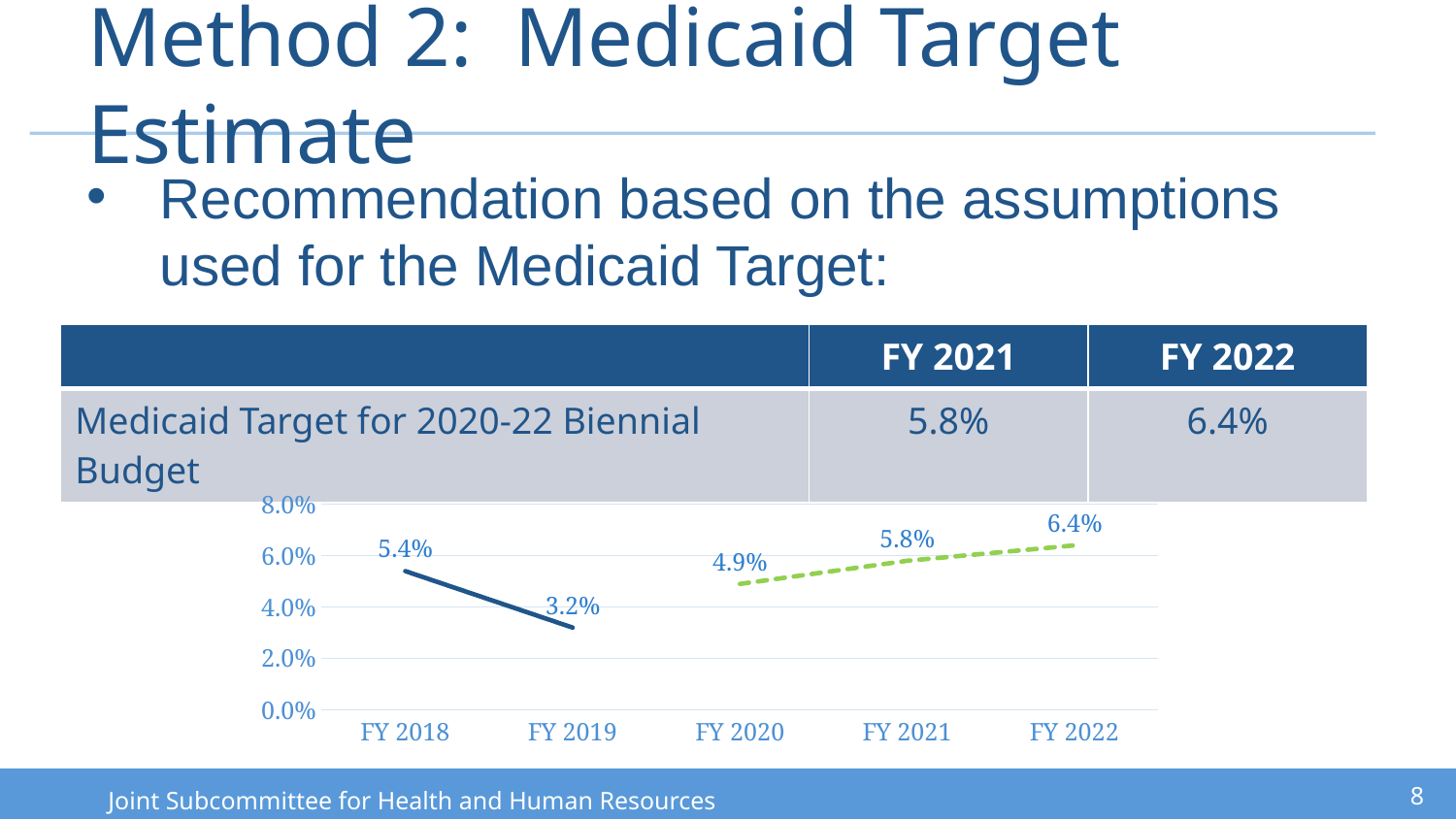
Which fiscal year has the highest value on the line chart? FY 2022 How many fiscal years are shown on the x axis of the line chart? 5 What is the value for FY 2020 on the line chart? 4.9% Which is larger on the line chart, the value for FY 2018 or the value for FY 2020? FY 2018 Do the values on the line chart rise or fall from FY 2020 to FY 2022? Rise What is the value for FY 2019 on the line chart? 3.2% What is the difference between the FY 2018 value and the FY 2019 value on the line chart? 2.2% What kind of chart is shown on the slide? Line chart What is the difference between the FY 2022 value and the FY 2021 value on the line chart? 0.6% Which fiscal year has the lowest value on the line chart? FY 2019 What is the value for FY 2018 on the line chart? 5.4% What is the value for FY 2022 on the line chart? 6.4%